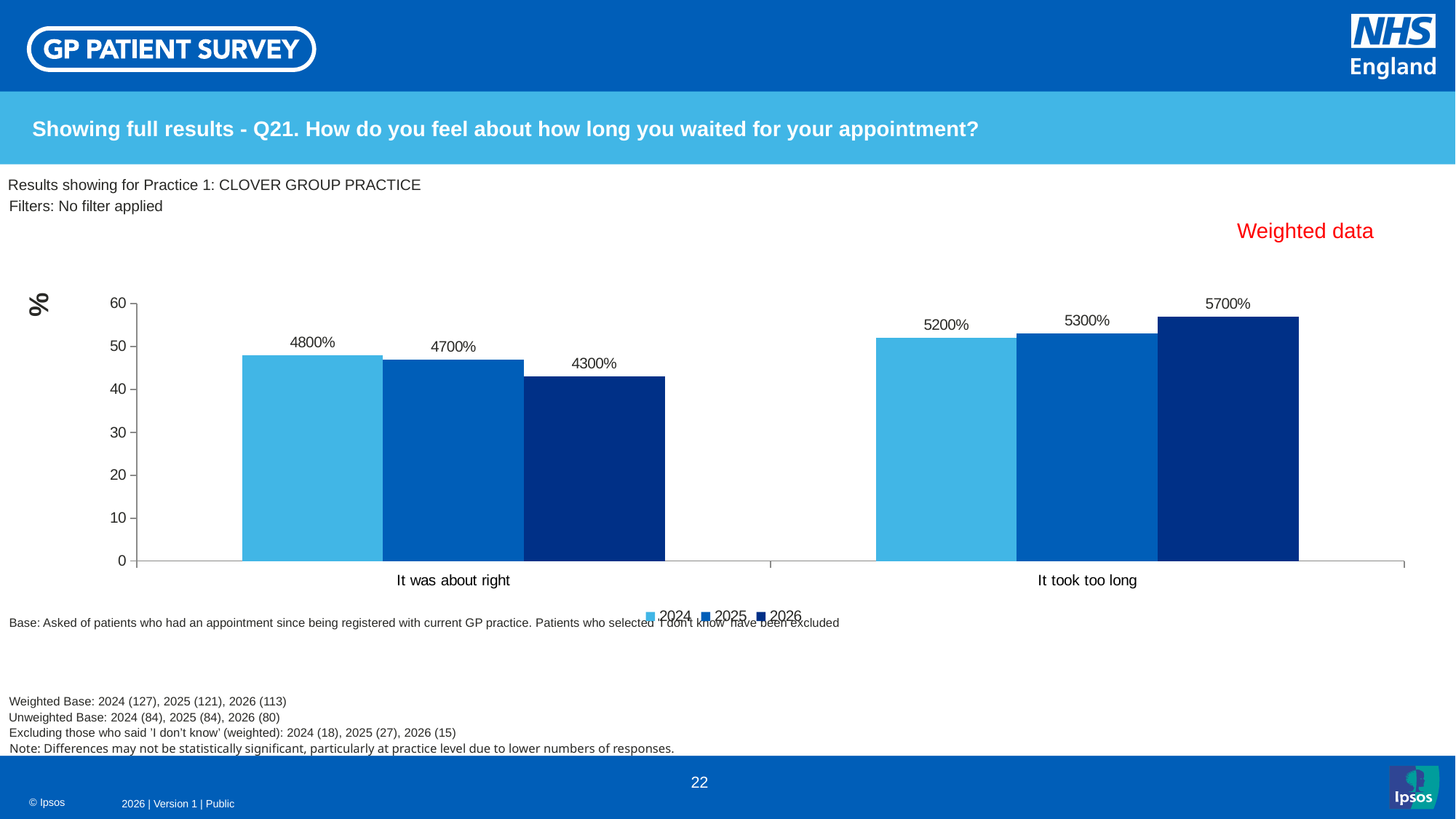
What kind of chart is shown on the slide? Bar chart What is the value for 2025 in the 'It was about right' category? 4700% How many categories are shown on the x axis? 2 Which year has the highest value in the 'It took too long' category? 2026 Which year has the lowest value in the 'It was about right' category? 2026 What is the value for 2026 in the 'It took too long' category? 5700% What is the value for 2024 in the 'It was about right' category? 4800% Do the values for 'It took too long' rise or fall from 2024 to 2026? Rise What is the difference between the 2024 and 2026 values in the 'It was about right' category, as labelled? 500% What is the value for 2024 in the 'It took too long' category? 5200% Which is larger: the 2025 value for 'It was about right' or the 2025 value for 'It took too long'? It took too long How many series does the legend list? 3